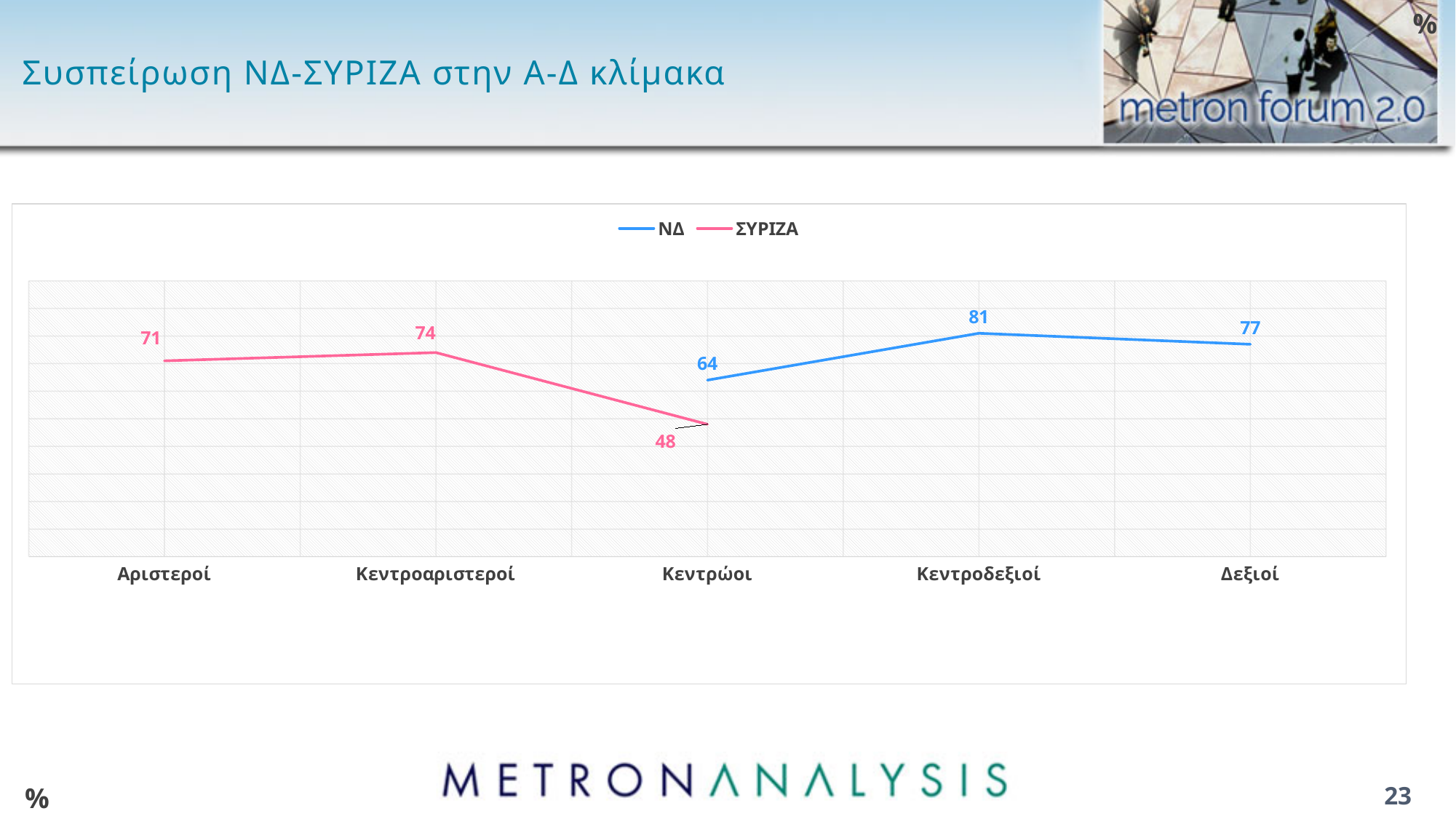
What is the ΣΥΡΙΖΑ value for Αριστεροί? 71 What is the ΝΔ value for Δεξιοί? 77 How many series does the legend list? 2 What is the ΣΥΡΙΖΑ value for Κεντροαριστεροί? 74 Which category has the lowest ΣΥΡΙΖΑ value? Κεντρώοι What kind of chart is shown on the slide? Line chart What is the ΝΔ value for Κεντροδεξιοί? 81 Which category has the highest ΝΔ value? Κεντροδεξιοί What is the ΝΔ value for Κεντρώοι? 64 Which is larger: the ΝΔ value for Κεντροδεξιοί or the ΝΔ value for Δεξιοί? Κεντροδεξιοί What is the ΣΥΡΙΖΑ value for Κεντρώοι? 48 What is the difference between the ΝΔ value and the ΣΥΡΙΖΑ value for Κεντρώοι? 16